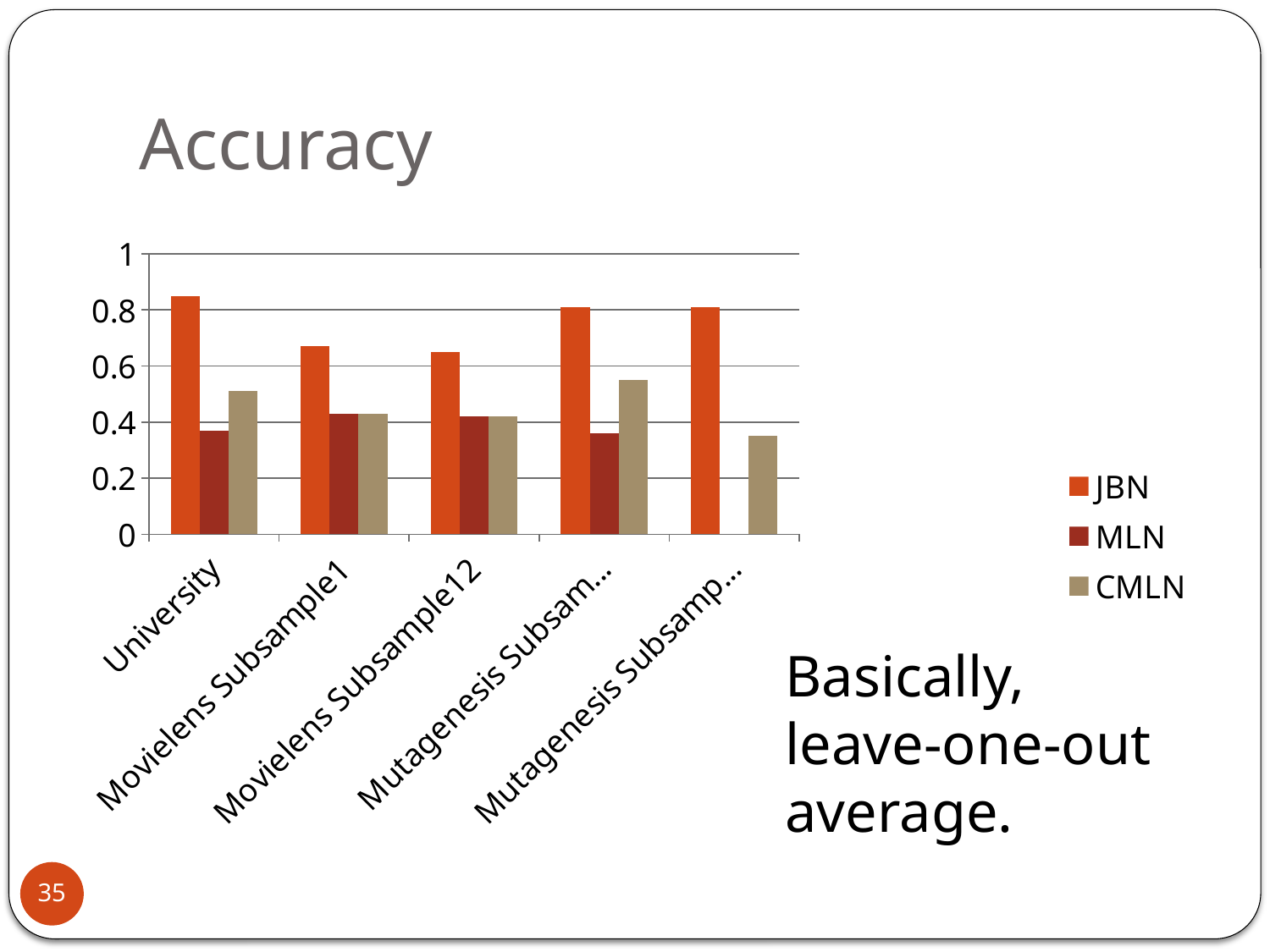
Is the JBN value for Movielens Subsample12 greater or less than 0.8? less What kind of chart is shown on the slide? bar chart What is the title of the chart? Accuracy Which category has the highest JBN value? University Is the MLN value for University greater or less than 0.4? less How many categories are shown on the x axis? 5 Is the CMLN value for University greater or less than 0.4? greater How many series does the legend list? 3 For University, which is larger: the JBN value or the CMLN value? JBN Which series has the highest value for Movielens Subsample1? JBN